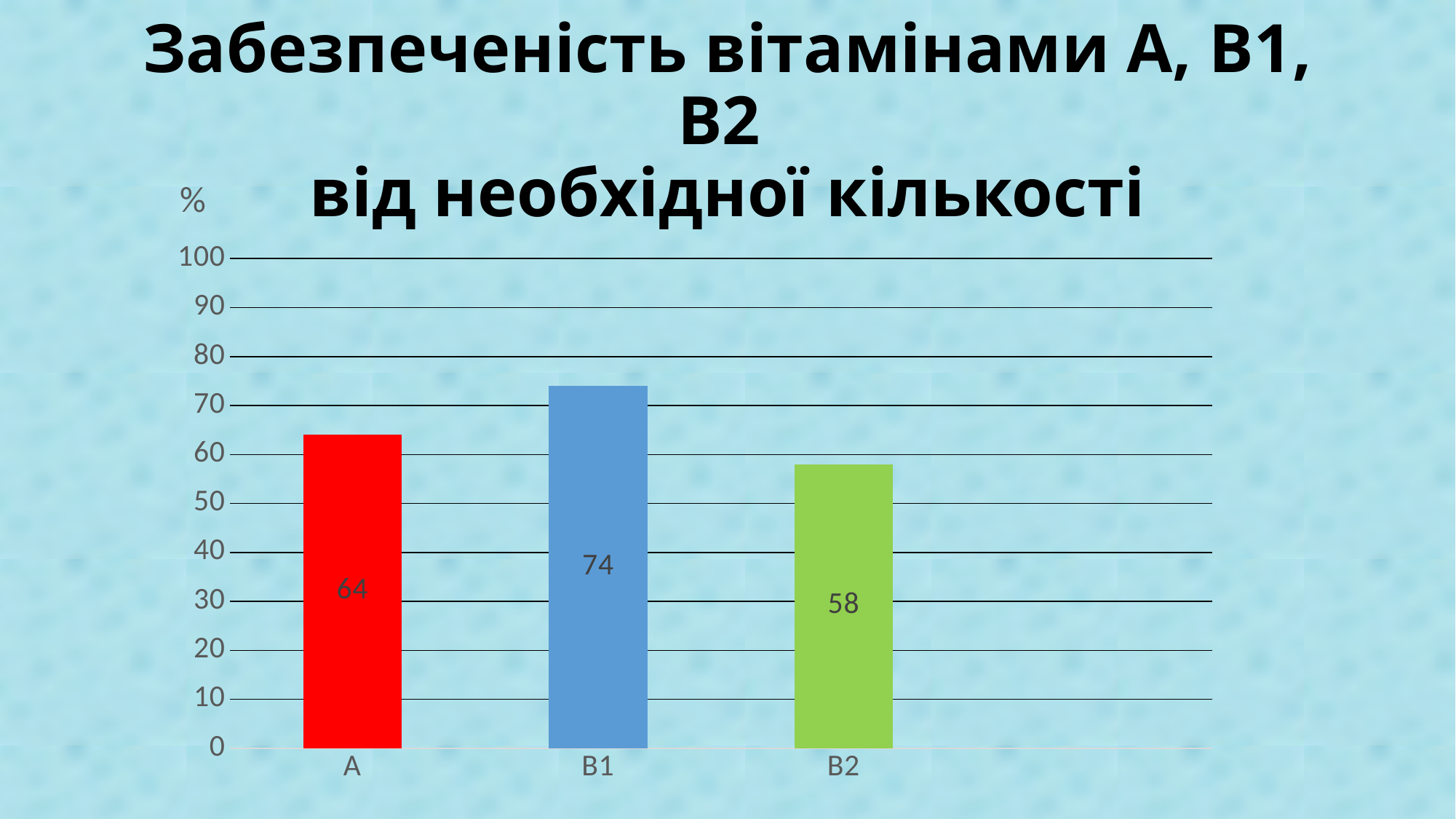
What colour is the bar for vitamin B2? green Which vitamin has the lowest value? B2 How many categories are shown on the chart? 3 What is the value for vitamin A? 64 Which is larger, the value for A or the value for B2? A What is the difference between the values for B1 and A? 10 What is the value for vitamin B2? 58 Is the value for B1 greater or less than 70? greater What is the value for vitamin B1? 74 What is the difference between the values for A and B2? 6 What kind of chart is shown on the slide? bar chart Which vitamin has the highest value? B1